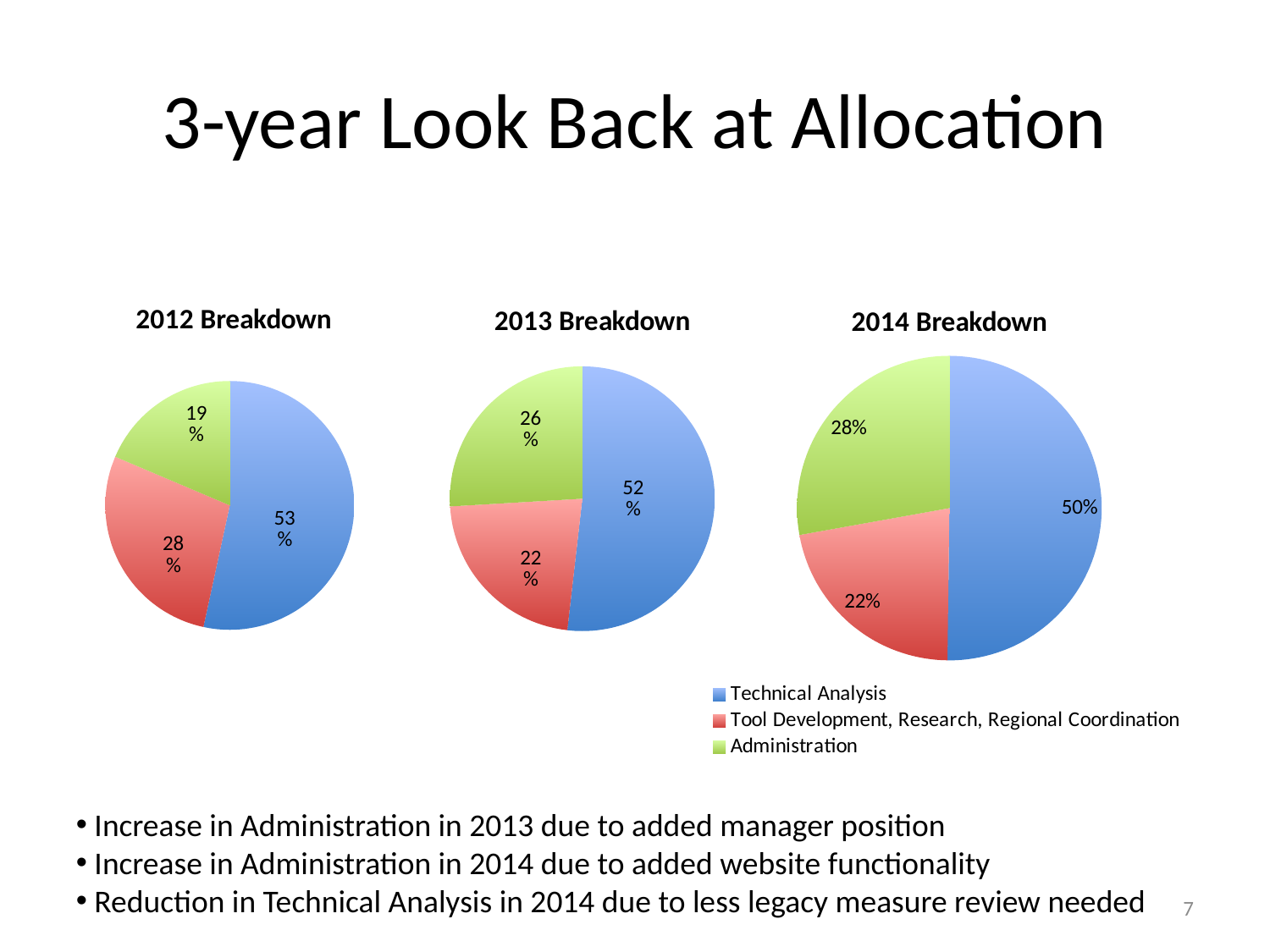
In the 2014 Breakdown chart, what share does Administration have? 28% In the 2012 Breakdown chart, what share does Technical Analysis have? 53% In the 2014 Breakdown chart, which is larger: the Administration slice or the Tool Development, Research, Regional Coordination slice? Administration What colour represents Administration in the pie charts? Green In the 2012 Breakdown chart, what share does Administration have? 19% In the 2012 Breakdown chart, which category has the smallest slice? Administration In the 2014 Breakdown chart, which category has the largest slice? Technical Analysis In the 2013 Breakdown chart, what share does Tool Development, Research, Regional Coordination have? 22% What kind of chart is the 2012 Breakdown chart? Pie chart In the 2013 Breakdown chart, what is the difference between the Technical Analysis share and the Administration share? 26% How many series does the legend list? 3 How many slices does the 2013 Breakdown chart have? 3